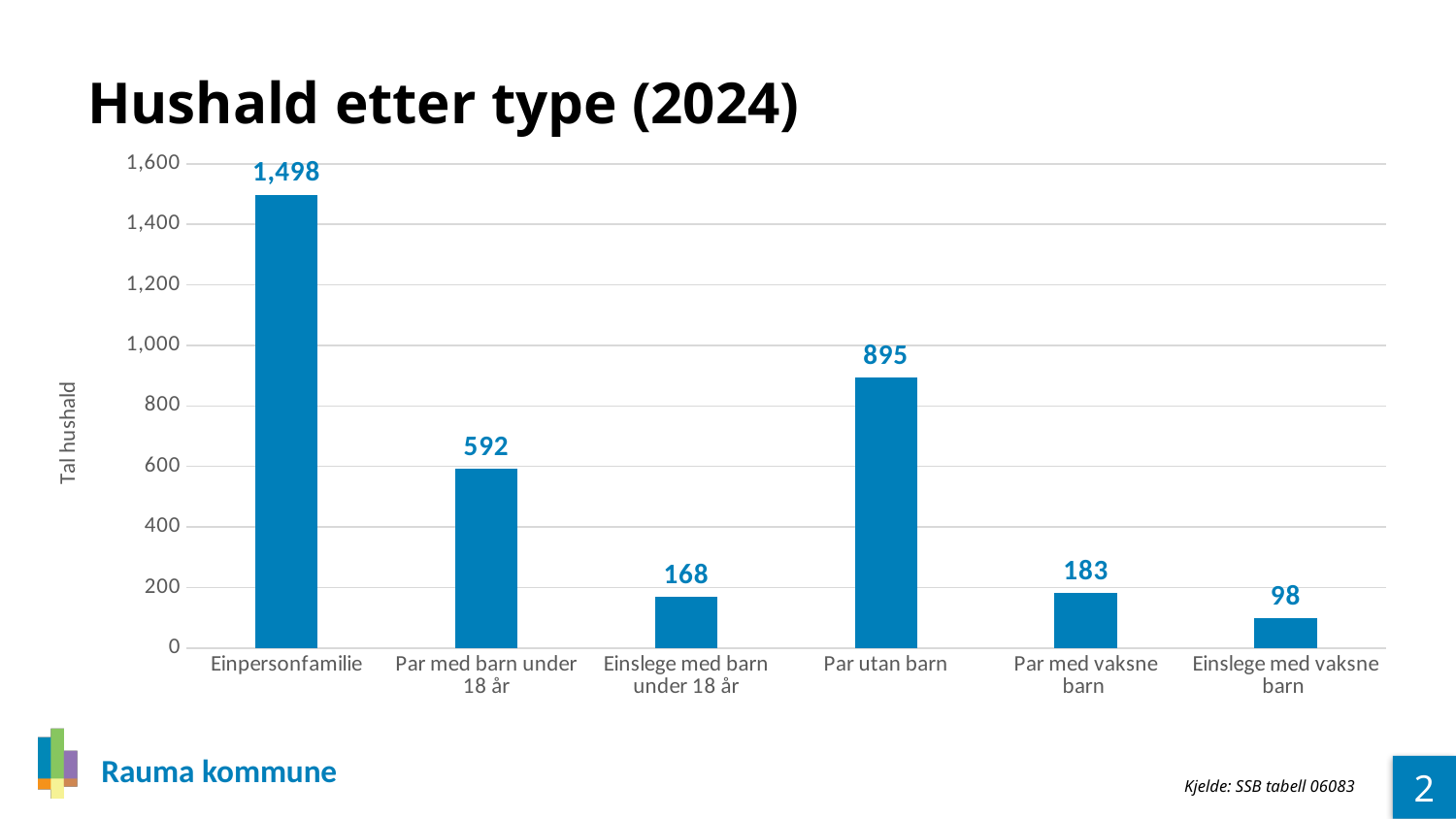
Which household type has the highest value? Einpersonfamilie What is the value for Par utan barn? 895 Which household type has the lowest value? Einslege med vaksne barn Is the value for Par med barn under 18 år greater or less than 400? greater Which is larger, Par med barn under 18 år or Par utan barn? Par utan barn What is the value for Einslege med vaksne barn? 98 What is the title of the chart? Hushald etter type (2024) What is the value for Einpersonfamilie? 1,498 What kind of chart is shown on the slide? bar chart What is the difference between Einpersonfamilie and Par utan barn? 603 What is the difference between Par med vaksne barn and Einslege med barn under 18 år? 15 How many household types are shown on the chart? 6